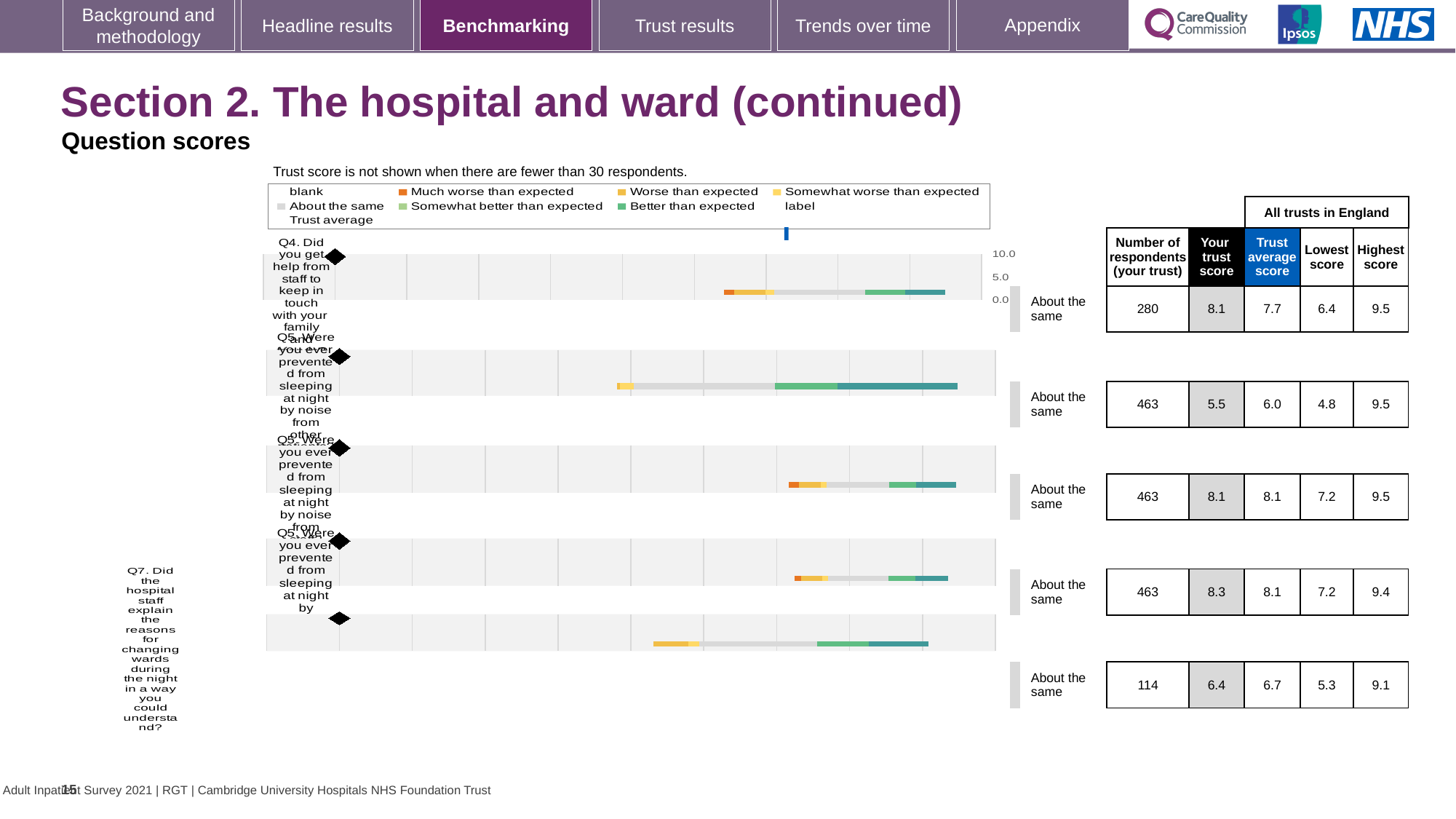
What kind of chart is used to show the question scores? Bar chart How many question rows (bars) are plotted on the chart? 5 For the second row, which is larger: 'Your trust score' or the 'Trust average score'? Trust average score What is the highest value shown on the chart's score axis? 10.0 What is the 'Your trust score' for the top row (Q4, help from staff to keep in touch with family and friends)? 8.1 What is the 'Trust average score' for the bottom row (Q7, explaining reasons for changing wards during the night)? 6.7 What rating label is shown next to every row of the chart? About the same What is the 'Highest score' for the second row from the top? 9.5 How many respondents does the table show for the top row (Q4)? 280 For the top row (Q4), what is the difference between 'Your trust score' and the 'Trust average score'? 0.4 Which row has the highest 'Your trust score'? The fourth row (8.3) Which row has the lowest 'Your trust score'? The second row (5.5)